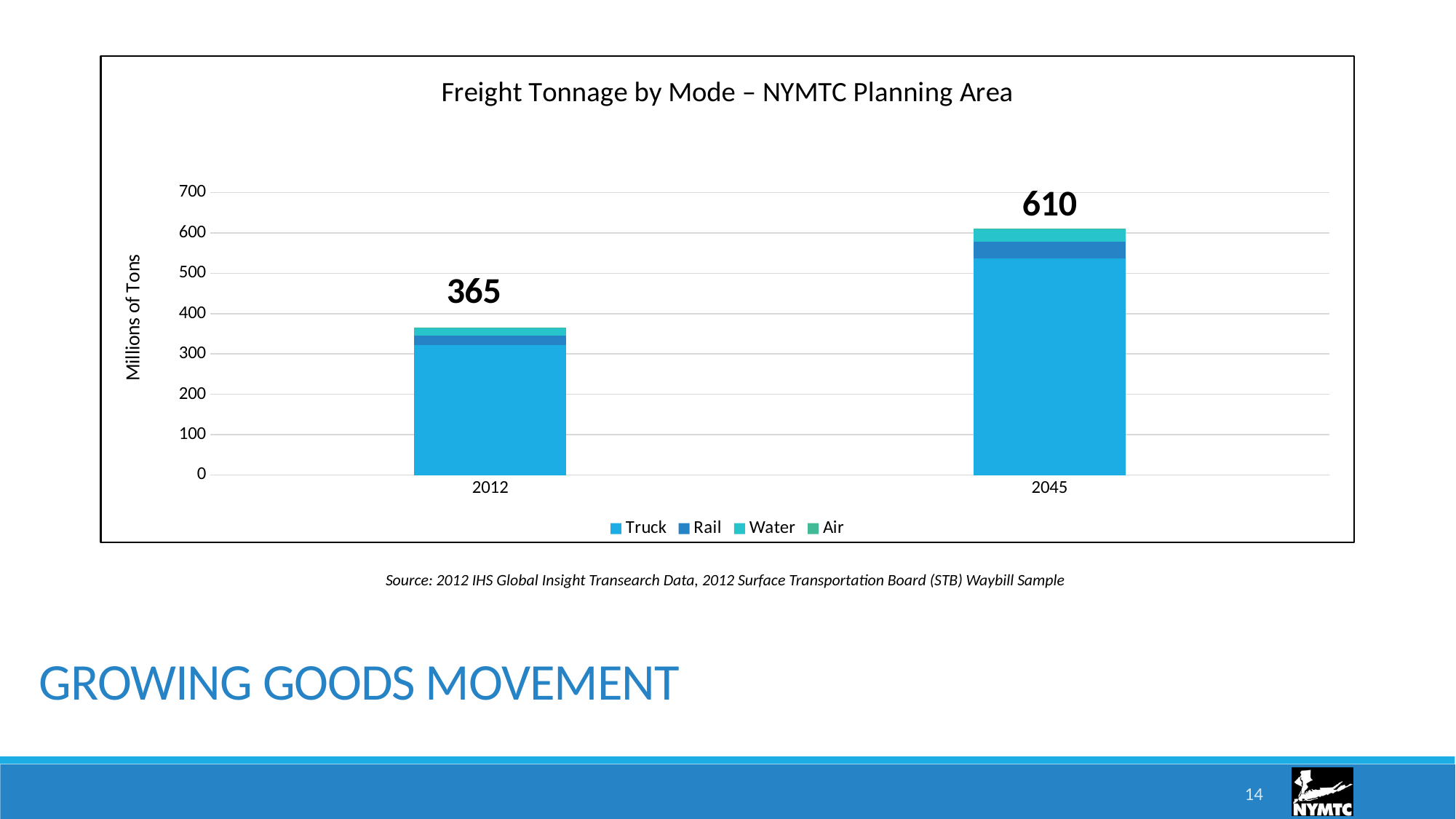
What is the total freight tonnage shown for 2012? 365 What kind of chart is shown? Stacked bar chart Does the total freight tonnage rise or fall from 2012 to 2045? Rise Which year has the lower total freight tonnage? 2012 Is the Truck value for 2045 greater or less than 500? greater Is the Truck value for 2012 greater or less than 400? less By how much does the total for 2045 exceed the total for 2012? 245 How many years are shown on the x axis? 2 How many series does the legend list? 4 What is the title of the chart? Freight Tonnage by Mode – NYMTC Planning Area What is the total freight tonnage shown for 2045? 610 Which year has the higher total freight tonnage? 2045